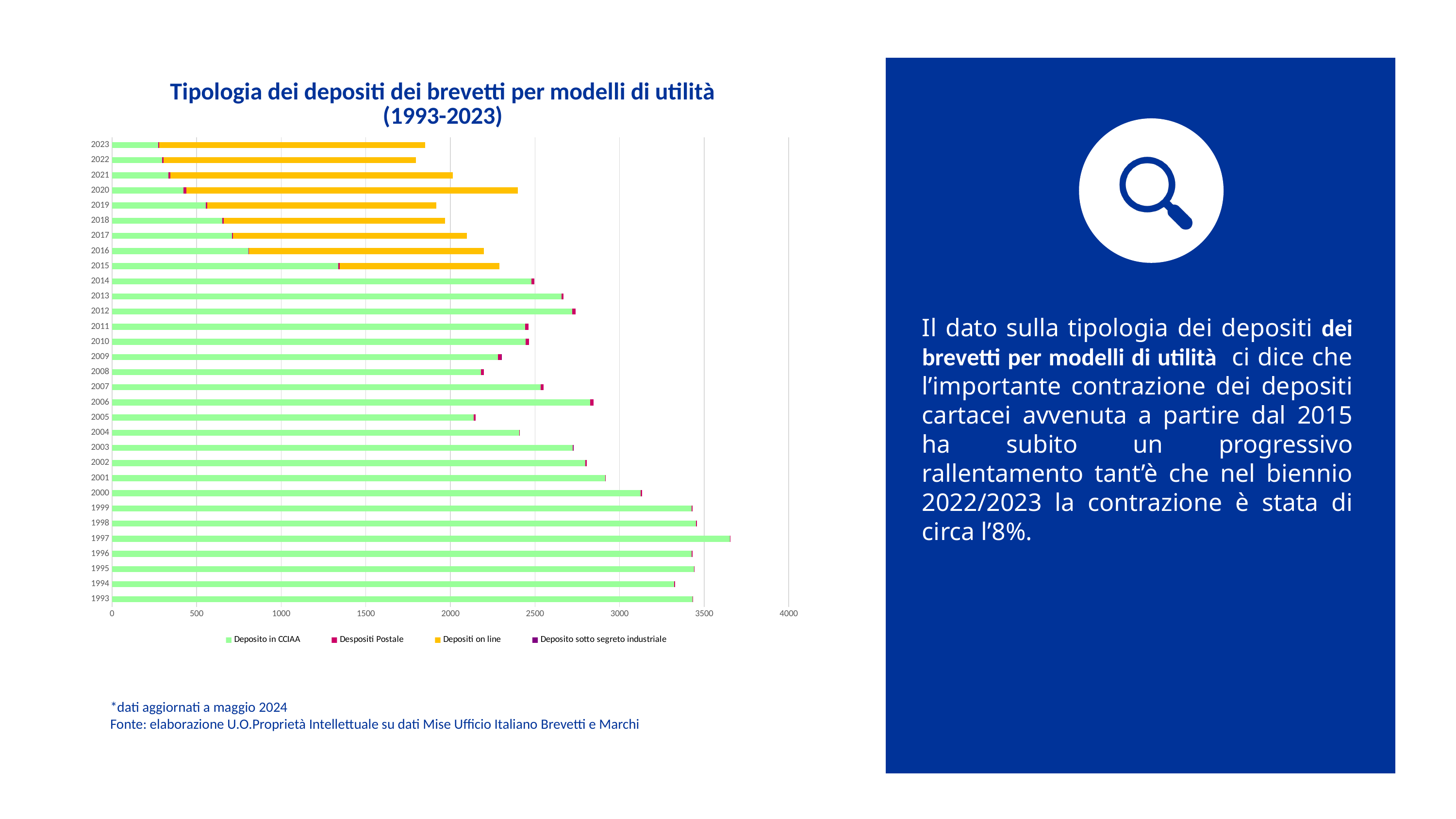
Is the total value for 2000 greater or less than 3000? greater What is the title of the chart? Tipologia dei depositi dei brevetti per modelli di utilità (1993-2023) Is the total value for 1997 greater or less than 3500? greater Which year has the longest total bar? 1997 What kind of chart is shown on the slide? Stacked horizontal bar chart How many series does the legend list? 4 Which colour represents the Depositi on line series in the legend? Orange Is the total value for 2020 greater or less than 2000? greater Does the Deposito in CCIAA segment rise or fall from 2015 to 2023? fall Which year has the larger total bar, 2020 or 2019? 2020 How many years (categories) are plotted on the chart? 31